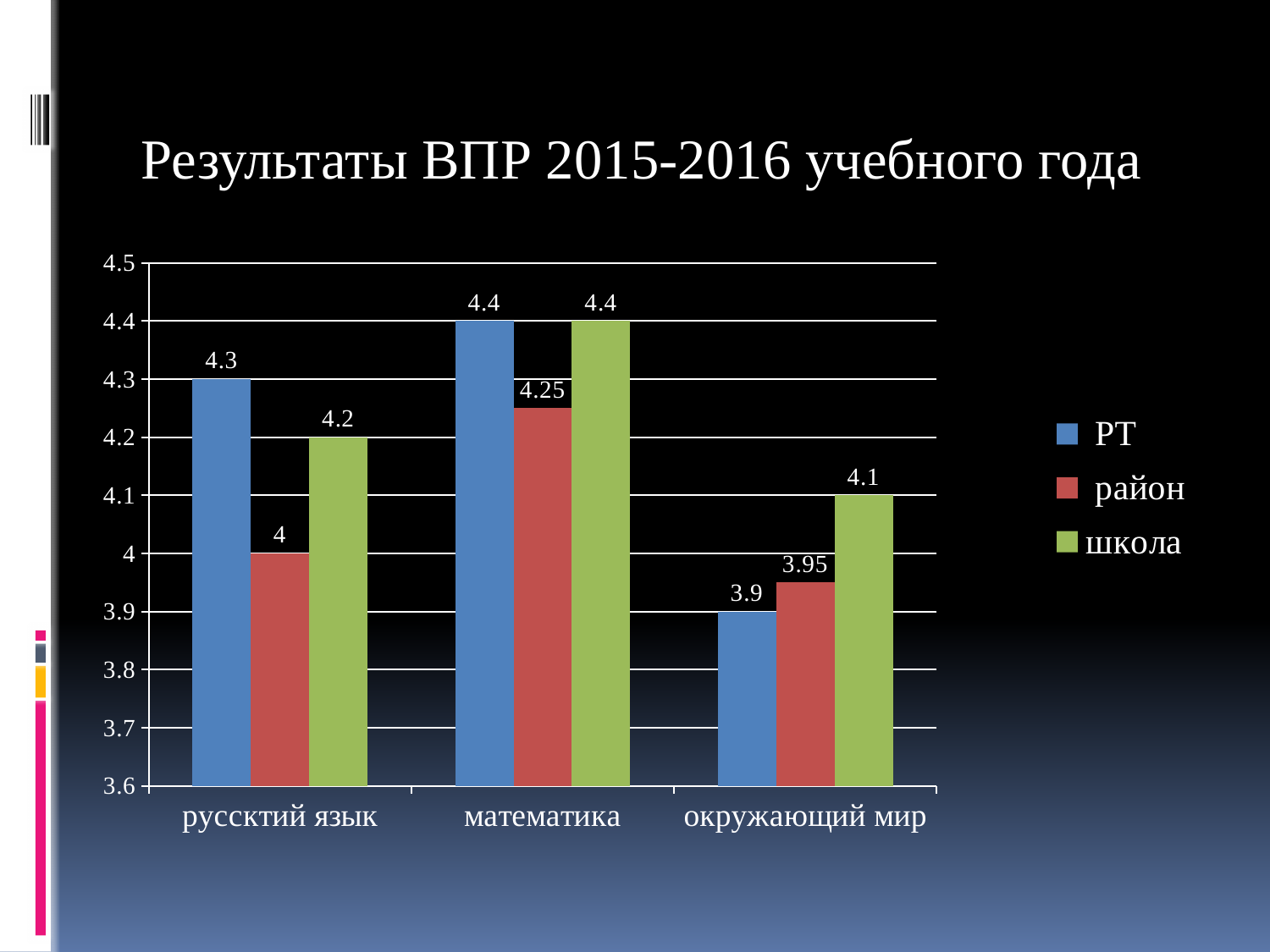
Which category has the highest value for район? математика Which category has the lowest value for РТ? окружающий мир What is the value for РТ in русский язык? 4.3 What kind of chart is shown on the slide? bar chart Is the value for район in русский язык greater or less than 4.1? less What is the value for школа in окружающий мир? 4.1 How many categories are shown on the x axis? 3 How many series does the legend list? 3 What is the value for район in окружающий мир? 3.95 Which is larger in окружающий мир: the value for РТ or the value for школа? школа What is the value for район in математика? 4.25 What is the difference between the РТ and район values in русский язык? 0.3